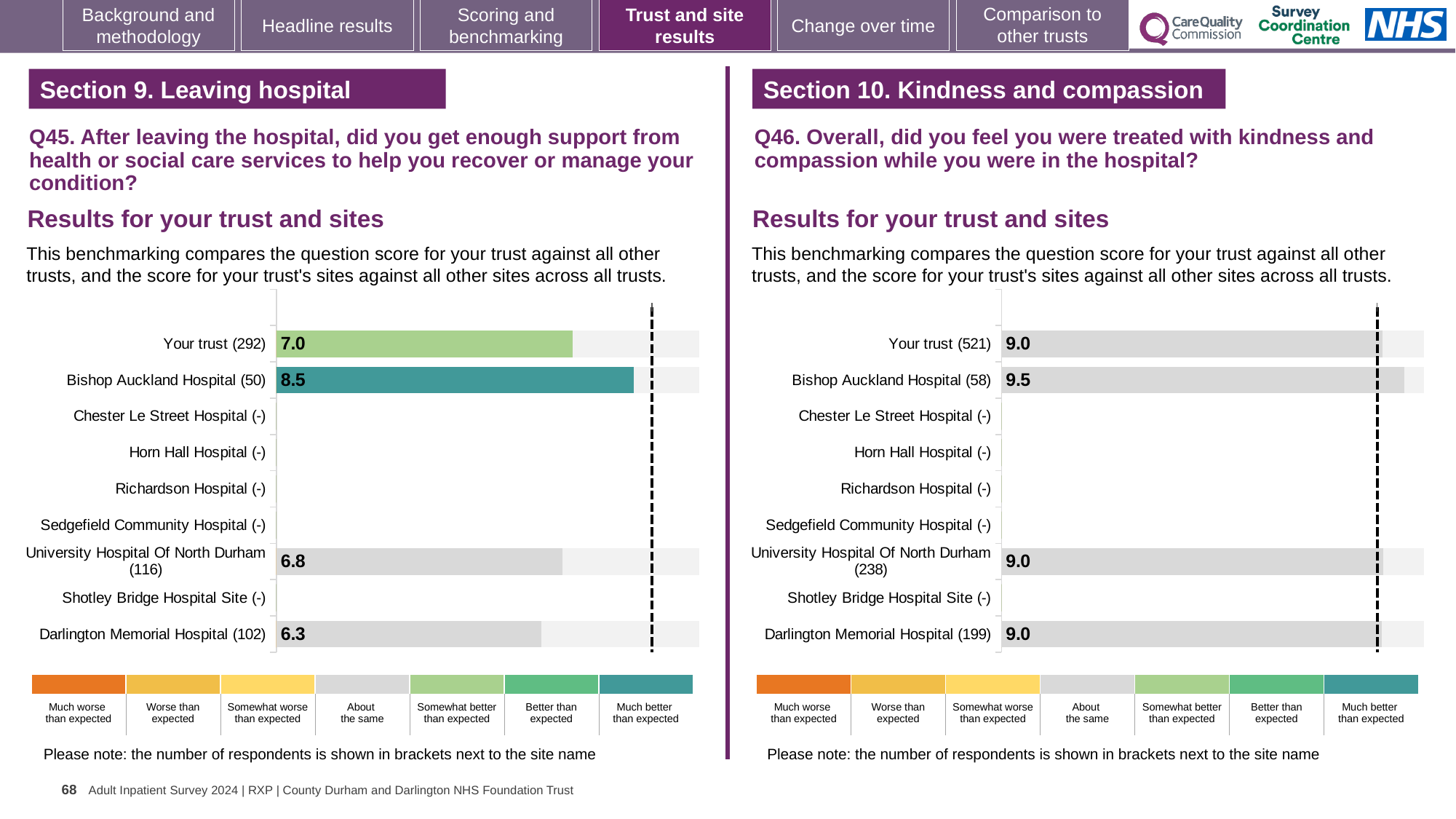
In the Q46 chart on the right, what is the score for Your trust? 9.0 In the Q46 chart on the right, how many respondents are shown for University Hospital Of North Durham? 238 In the Q45 chart on the left, what is the difference between the scores for Bishop Auckland Hospital and University Hospital Of North Durham? 1.7 What type of chart is used for the Q45 results on the left? Bar chart In the Q45 chart on the left, what colour is the bar for Bishop Auckland Hospital? Teal (much better than expected) How many site or trust rows are listed on the y axis of the Q46 chart on the right? 9 In the Q45 chart on the left, which site has the lowest score? Darlington Memorial Hospital In the Q45 chart on the left, which is higher: the score for Your trust or for University Hospital Of North Durham? Your trust In the Q46 chart on the right, what is the difference between the scores for Bishop Auckland Hospital and Darlington Memorial Hospital? 0.5 In the Q45 chart on the left, what is the score for Bishop Auckland Hospital? 8.5 In the Q45 chart on the left, what is the score for Darlington Memorial Hospital? 6.3 In the Q46 chart on the right, which site has the highest score? Bishop Auckland Hospital